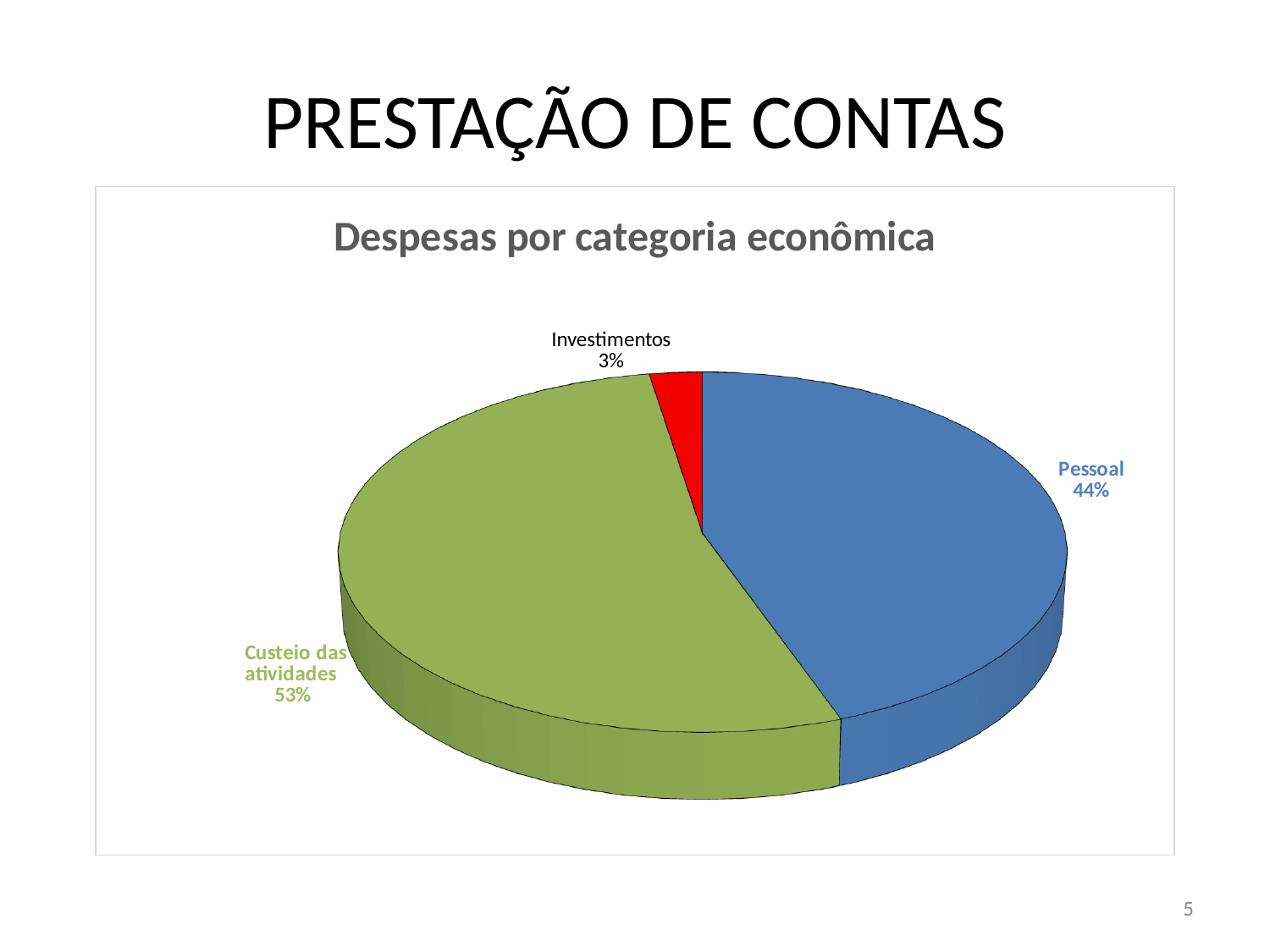
What colour is the Investimentos slice? Red What share of the pie does Custeio das atividades represent? 53% Which category has the smallest slice of the pie? Investimentos What share of the pie does Investimentos represent? 3% How many categories are shown in the pie chart? 3 What share of the pie does Pessoal represent? 44% Which is larger, the share for Pessoal or the share for Custeio das atividades? Custeio das atividades What is the difference in percentage points between Pessoal and Investimentos? 41 What is the title of the chart? Despesas por categoria econômica What kind of chart is shown on the slide? Pie chart Which category has the largest slice of the pie? Custeio das atividades What is the difference in percentage points between Custeio das atividades and Pessoal? 9